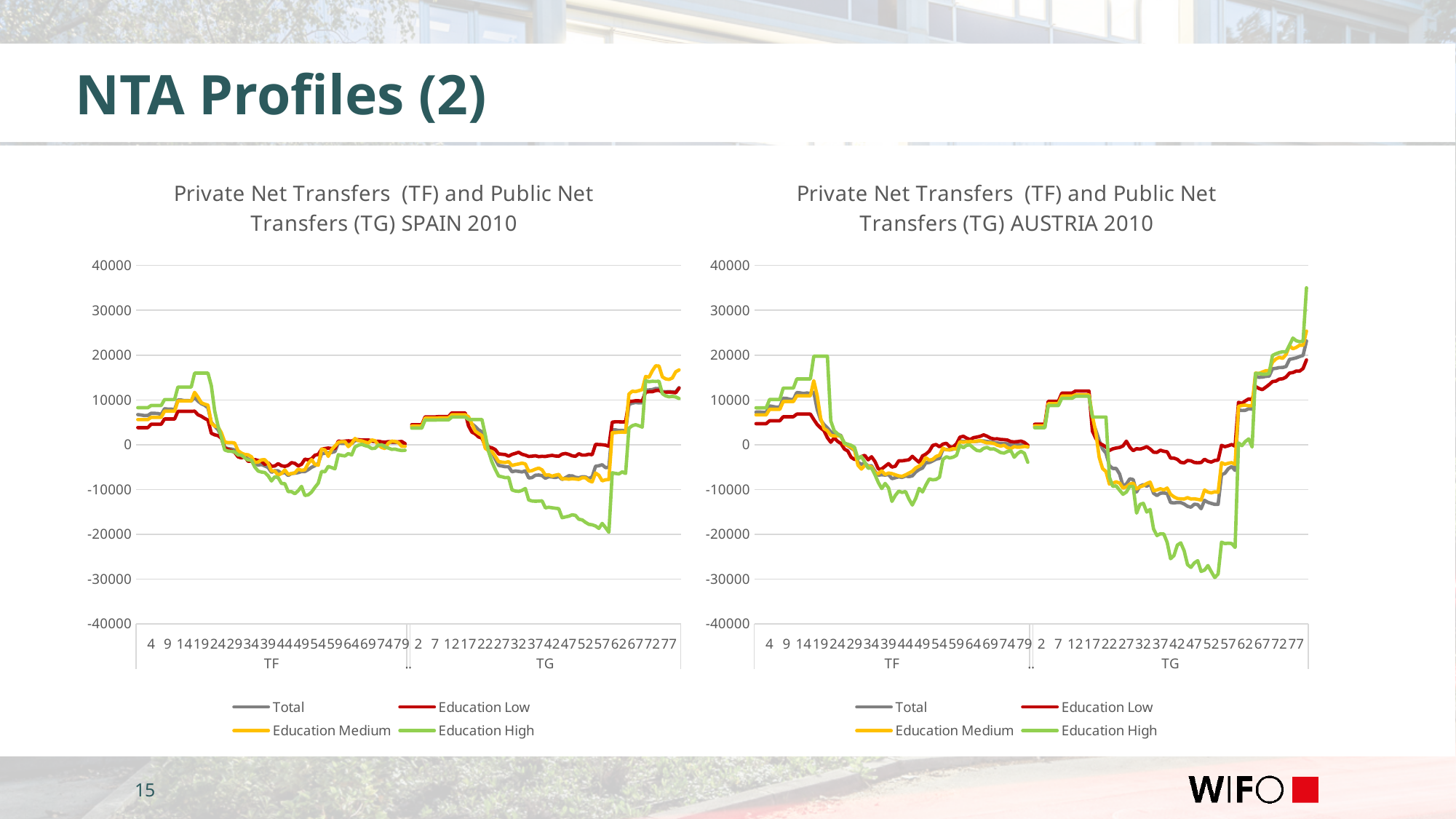
What are the two sections labelled on the x axis of the AUSTRIA 2010 chart? TF and TG In the SPAIN 2010 chart, around age 62 in the TG section, which is higher: Education Low or Education High? Education Low In the AUSTRIA 2010 chart, is the highest value of the Education High series in the TG section greater or less than 30000? greater How many series does the legend of the right chart (AUSTRIA 2010) list? 4 In the AUSTRIA 2010 chart, is the lowest value of the Education High series in the TG section greater or less than -20000? less In the SPAIN 2010 chart, which series reaches the lowest value in the TG section? Education High What colour is the Education Low series in the legend of the SPAIN 2010 chart? red What kind of chart is the left chart, 'Private Net Transfers (TF) and Public Net Transfers (TG) SPAIN 2010'? line chart In the SPAIN 2010 chart, is the peak of the Education High series in the TF section greater or less than 10000? greater In the AUSTRIA 2010 chart, around age 57 in the TG section, which is lower: Education High or Education Low? Education High In the AUSTRIA 2010 chart, which series reaches the highest value at the end of the TG section? Education High